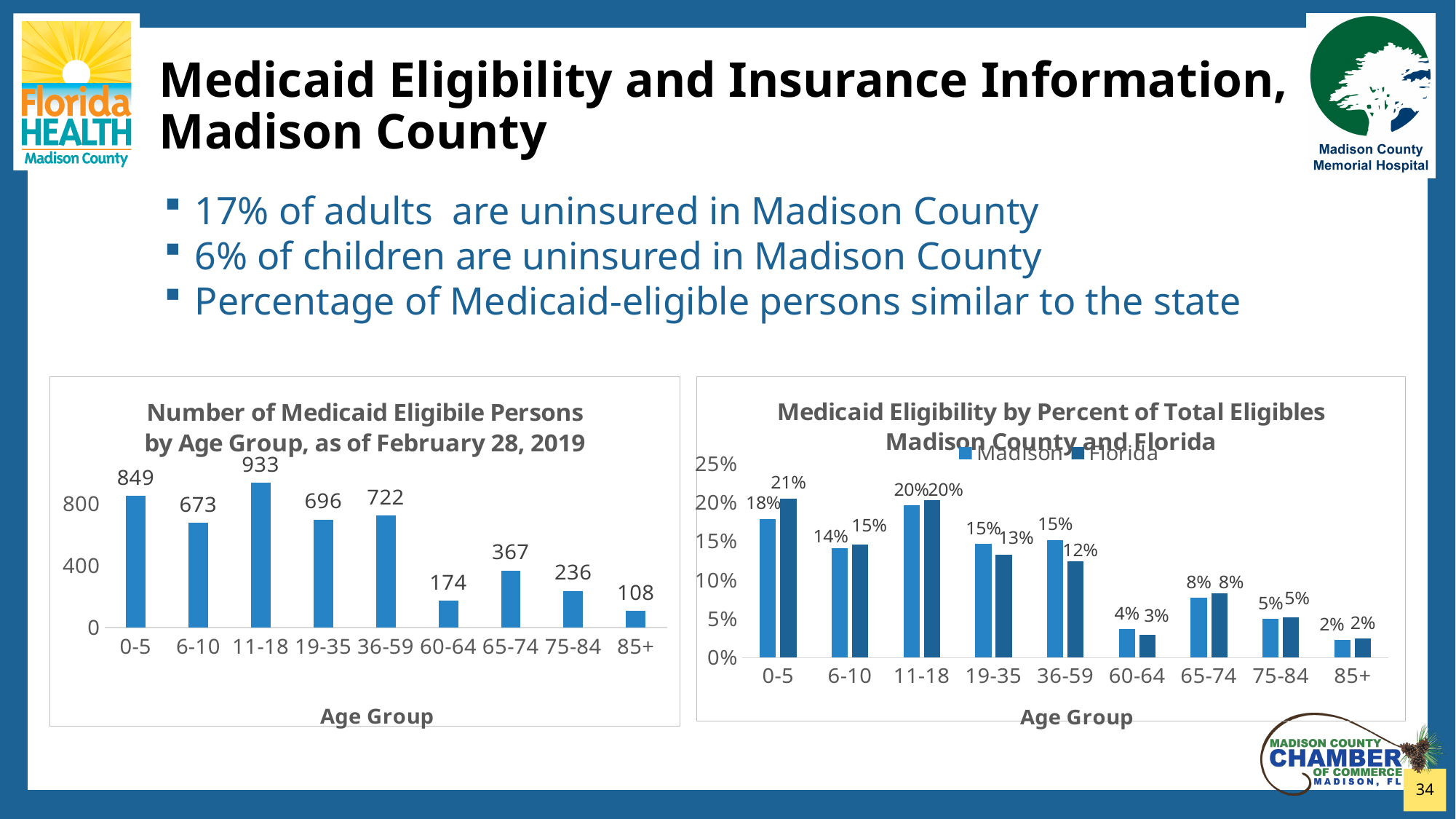
In the right chart (Medicaid Eligibility by Percent of Total Eligibles), how many series does the legend list? 2 In the left chart (Number of Medicaid Eligible Persons by Age Group), which is larger, the value for 65-74 or the value for 75-84? 65-74 In the right chart (Medicaid Eligibility by Percent of Total Eligibles), what is the Madison value for the 0-5 age group? 18% In the left chart (Number of Medicaid Eligible Persons by Age Group), which age group has the highest number of eligible persons? 11-18 In the left chart (Number of Medicaid Eligible Persons by Age Group), what is the difference between the 0-5 and 6-10 age groups? 176 In the left chart (Number of Medicaid Eligible Persons by Age Group), what is the value for the 11-18 age group? 933 What kind of chart is the left chart (Number of Medicaid Eligible Persons by Age Group)? Bar chart In the left chart (Number of Medicaid Eligible Persons by Age Group), how many age groups are shown on the x axis? 9 In the right chart (Medicaid Eligibility by Percent of Total Eligibles), which is larger for the 19-35 age group, Madison or Florida? Madison In the left chart (Number of Medicaid Eligible Persons by Age Group), which age group has the lowest number of eligible persons? 85+ In the right chart (Medicaid Eligibility by Percent of Total Eligibles), what is the difference between the Madison and Florida values for the 0-5 age group? 3% In the right chart (Medicaid Eligibility by Percent of Total Eligibles), what is the Florida value for the 36-59 age group? 12%